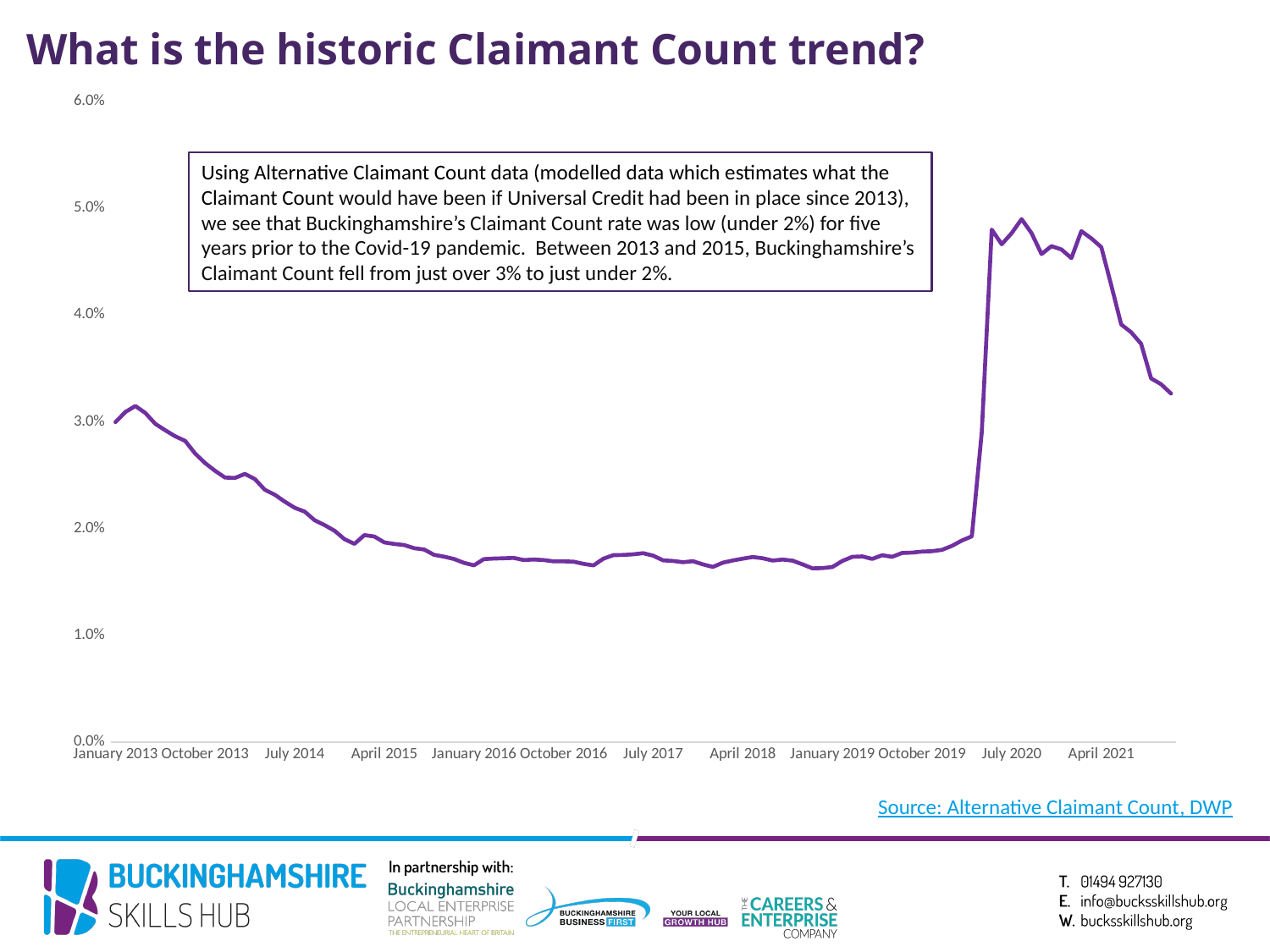
Is the value for April 2021 greater or less than 3.0%? greater How many date labels are shown along the x axis? 12 Does the Claimant Count rate rise or fall between January 2013 and July 2014? fall Is the value for January 2019 greater or less than 2.0%? less Which is larger, the value for July 2020 or the value for January 2016? July 2020 What kind of chart is shown on the slide? line chart Does the Claimant Count rate rise or fall between July 2020 and April 2021? fall Is the value for January 2013 greater or less than 2.0%? greater What is the title of the slide containing the chart? What is the historic Claimant Count trend? What source is cited for the chart data? Alternative Claimant Count, DWP